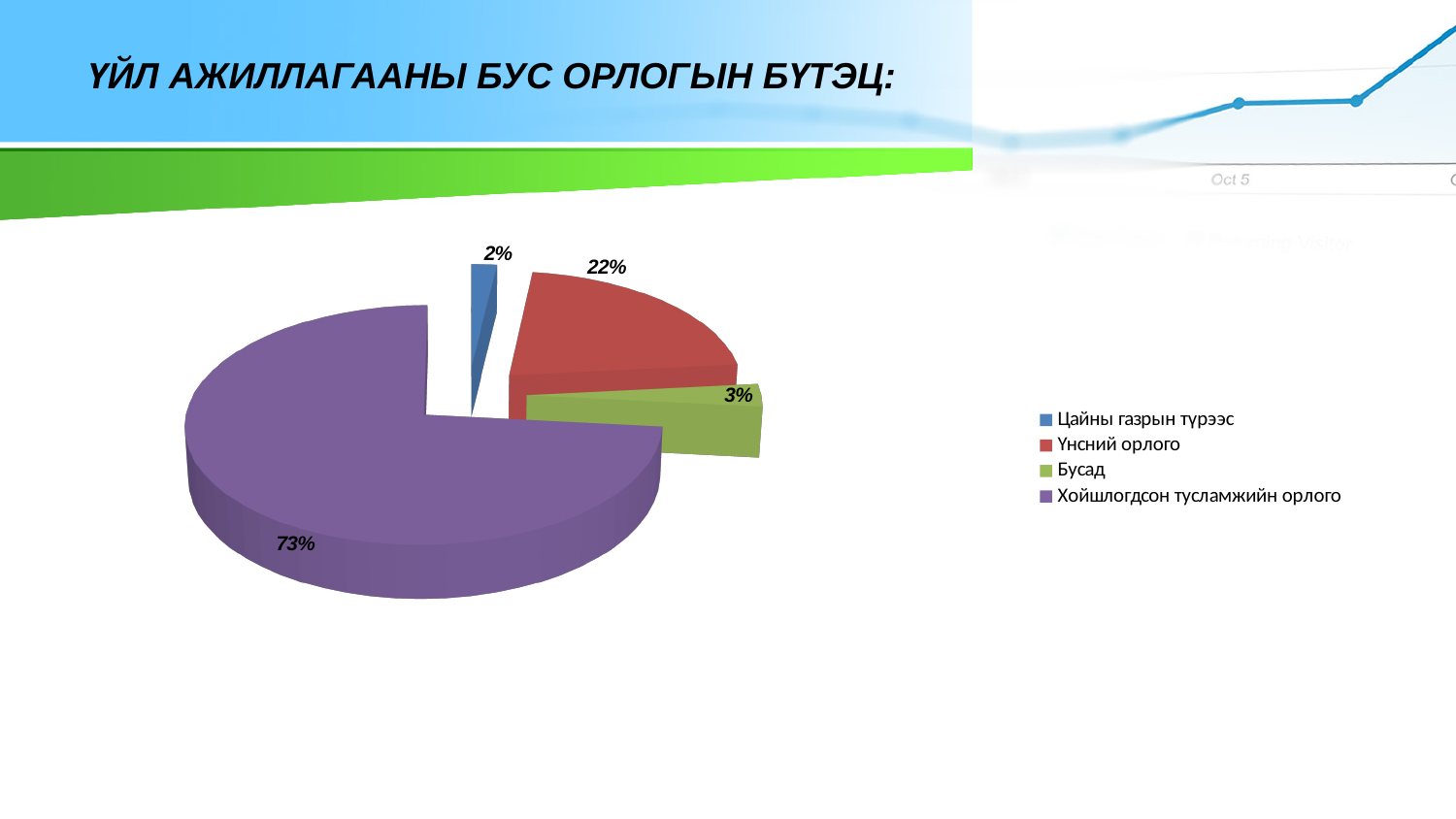
Which category has the largest slice of the pie? Хойшлогдсон тусламжийн орлого What is the difference in percentage points between Хойшлогдсон тусламжийн орлого and Үнсний орлого? 51 Which is larger, the share for Бусад or the share for Цайны газрын түрээс? Бусад What is the title of the slide containing the pie chart? ҮЙЛ АЖИЛЛАГААНЫ БУС ОРЛОГЫН БҮТЭЦ: What share of the pie does Үнсний орлого have? 22% What share of the pie does Бусад have? 3% What type of chart is shown on the slide? Pie chart How many categories does the pie chart have? 4 What colour is the slice for Үнсний орлого? Red What share of the pie does Хойшлогдсон тусламжийн орлого have? 73% Which category has the smallest slice of the pie? Цайны газрын түрээс